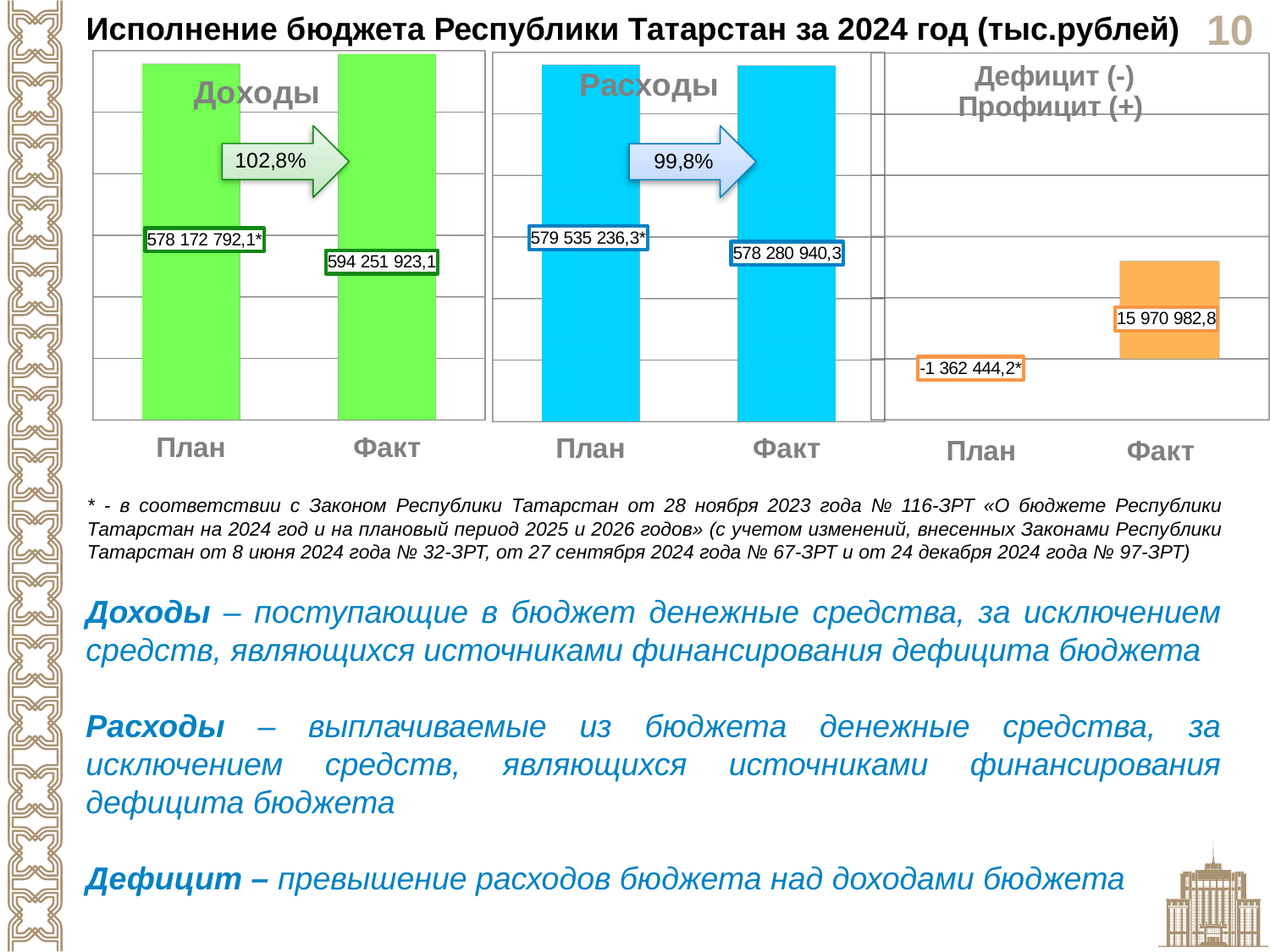
In the Дефицит (-) Профицит (+) chart, what is the value for План? -1 362 444,2 In the Доходы chart, what is the value for Факт? 594 251 923,1 What percentage is shown on the arrow in the Доходы chart? 102,8% What type of chart is the Расходы chart? bar chart In the Дефицит (-) Профицит (+) chart, what is the value for Факт? 15 970 982,8 In the Дефицит (-) Профицит (+) chart, which category has the lowest value? План In the Доходы chart, which is larger, План or Факт? Факт In the Расходы chart, what is the value for План? 579 535 236,3 In the Доходы chart, what is the difference between Факт and План? 16 079 131,0 In the Расходы chart, what is the difference between План and Факт? 1 254 296,0 In the Доходы chart, what is the value for План? 578 172 792,1 In the Расходы chart, what is the value for Факт? 578 280 940,3